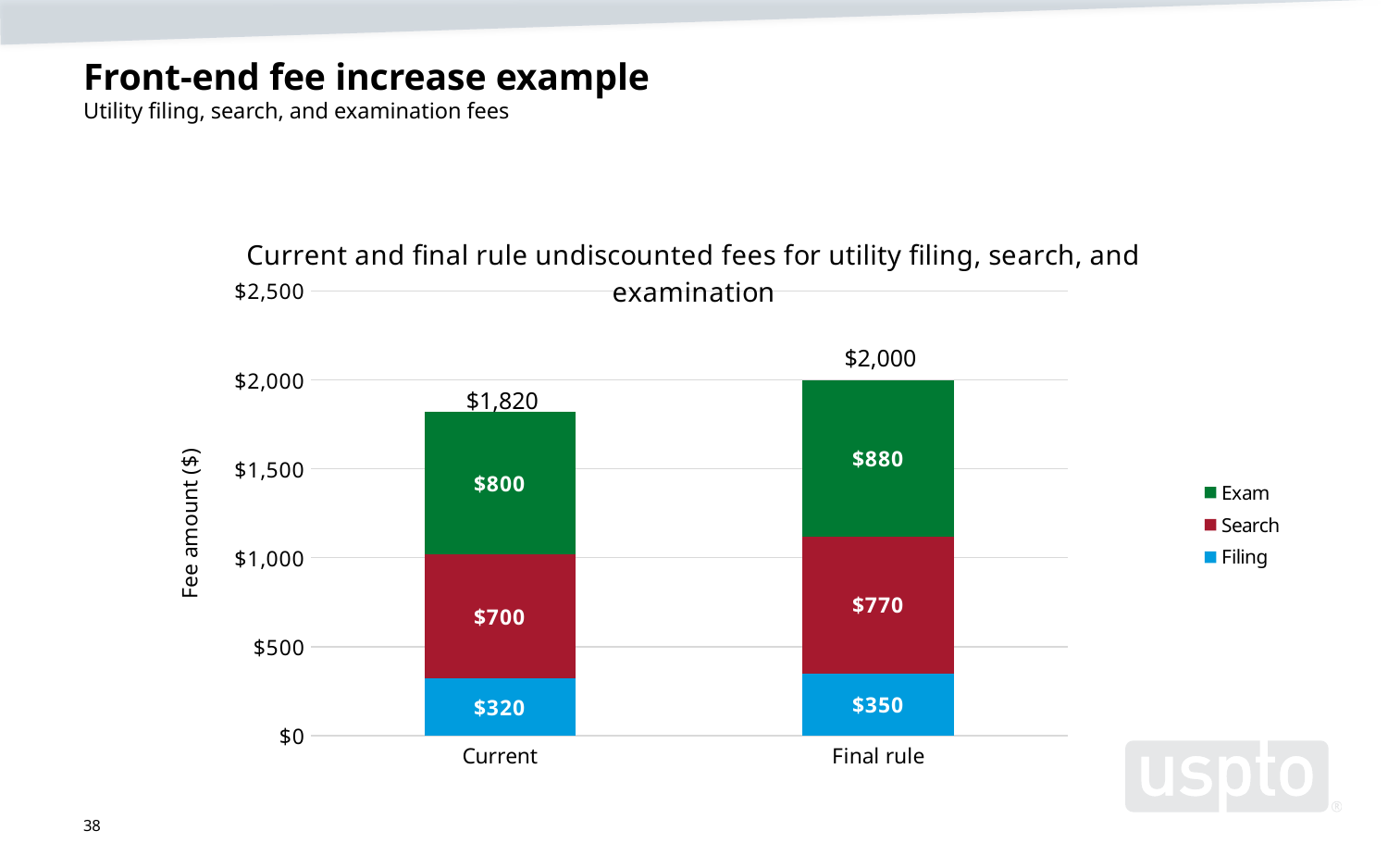
What is the Filing fee for the Final rule? $350 How much higher is the Final rule Exam fee than the Current Exam fee? $80 Which colour represents Filing in the chart? Blue What is the total fee for the Current bar? $1,820 Which fee component is the largest in the Current bar? Exam Which category has the higher Search fee, Current or Final rule? Final rule What is the total fee for the Final rule bar? $2,000 What kind of chart is shown? Stacked bar chart What is the difference between the Final rule total and the Current total? $180 What is the Search fee under Current? $700 How many series does the legend list? 3 What is the Exam fee for the Final rule? $880